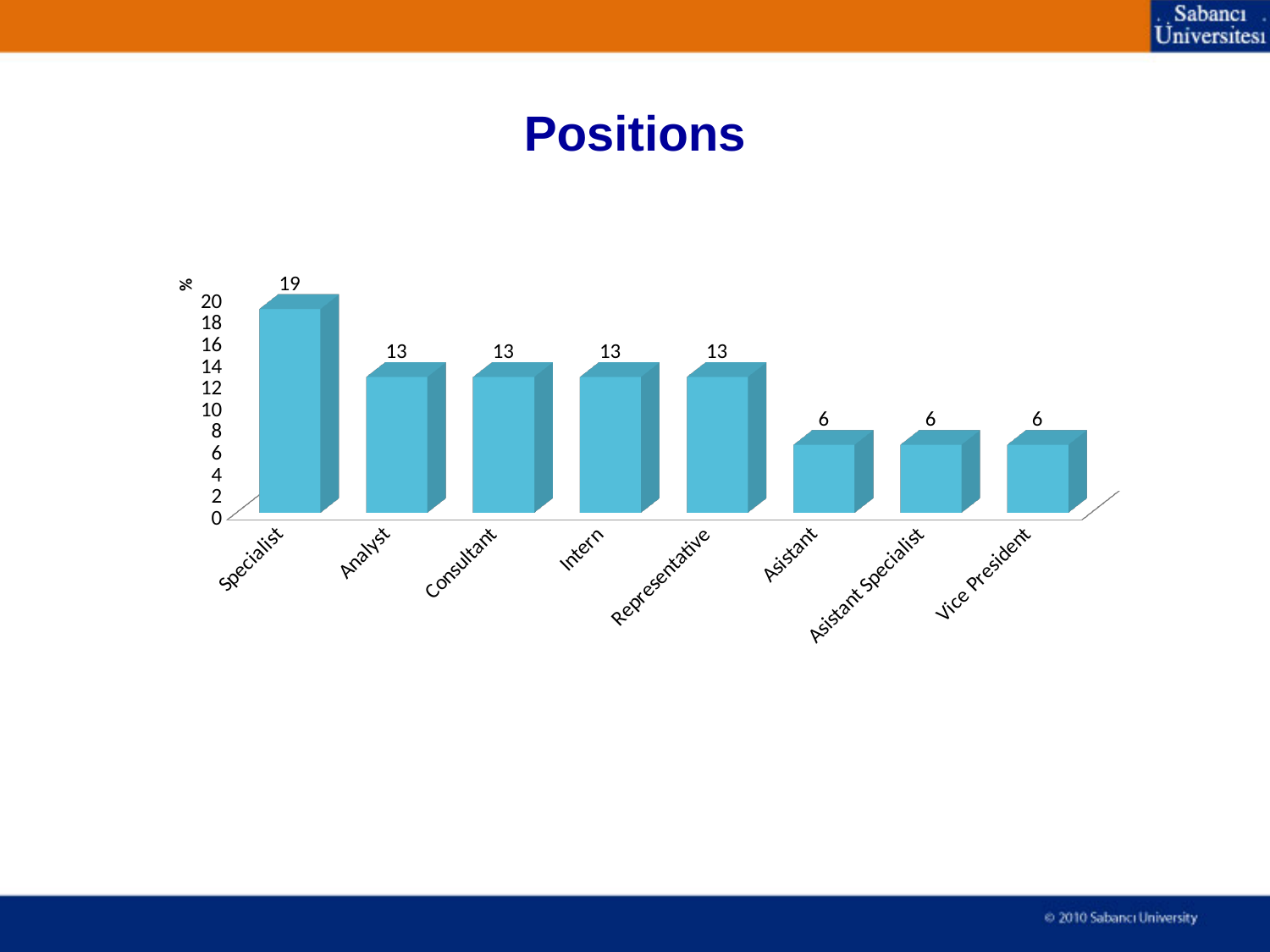
What is the title of the chart? Positions How many positions are shown on the chart? 8 What is the difference between the values for Specialist and Intern? 6 What kind of chart is shown on the slide? bar chart What is the value for Representative? 13 Which is larger, the value for Analyst or the value for Asistant Specialist? Analyst What is the difference between the values for Consultant and Asistant? 7 What is the value for Specialist? 19 What is the value for Vice President? 6 Is the value for Specialist greater or less than 16? greater What is the value for Analyst? 13 Which position has the highest value? Specialist